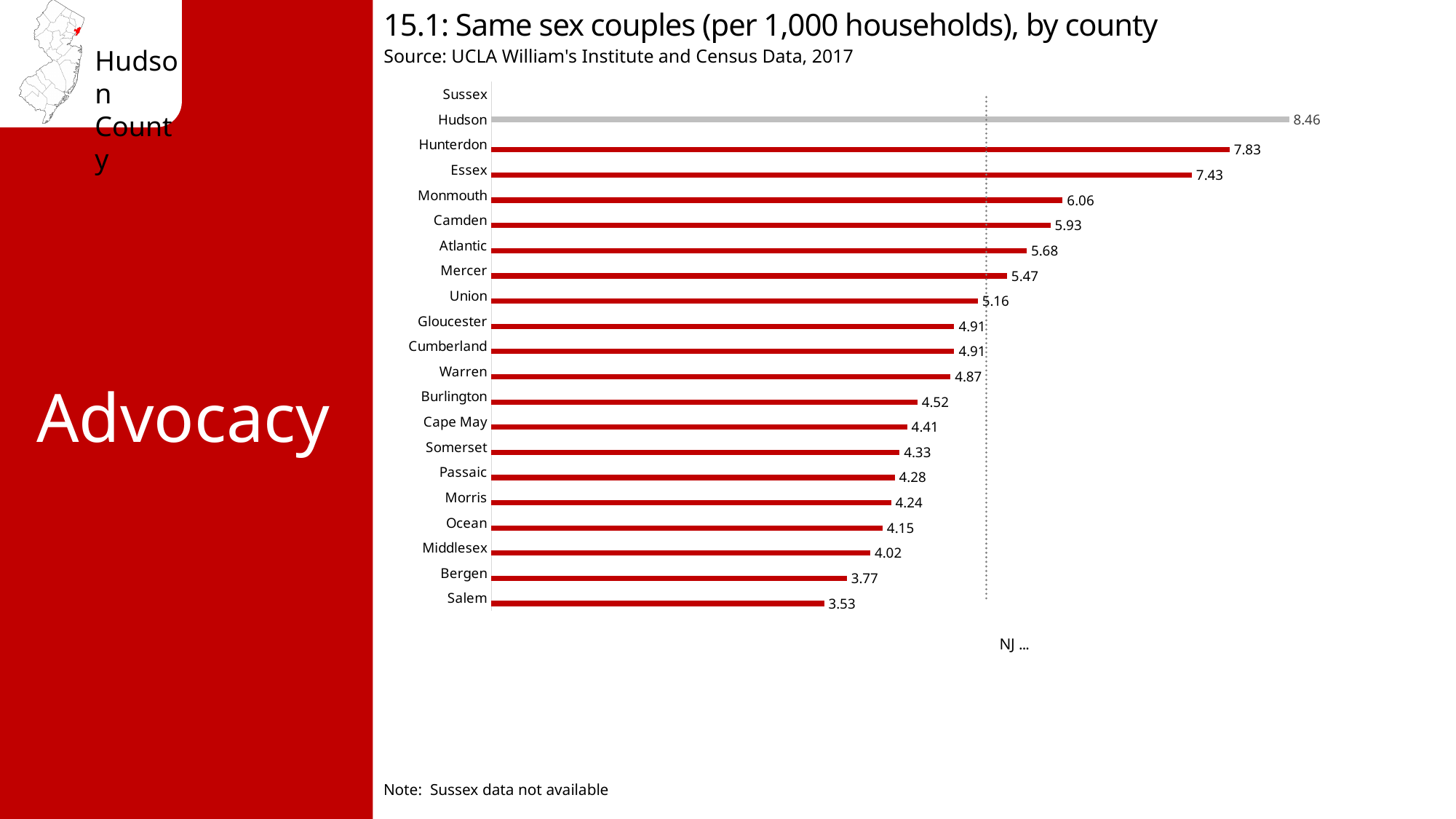
Which county has no bar plotted on the chart? Sussex Which county has the highest value shown? Hudson What is the title of the chart? 15.1: Same sex couples (per 1,000 households), by county What is the value for Essex County? 7.43 What is the value for Bergen County? 3.77 How many counties are listed on the chart's axis? 21 What kind of chart is shown on the slide? Bar chart Which county has the lowest value shown? Salem Which has a larger value, Monmouth or Camden? Monmouth What is the value for Hudson County? 8.46 Which has a larger value, Middlesex or Ocean? Ocean What is the difference between the values for Hudson and Hunterdon? 0.63